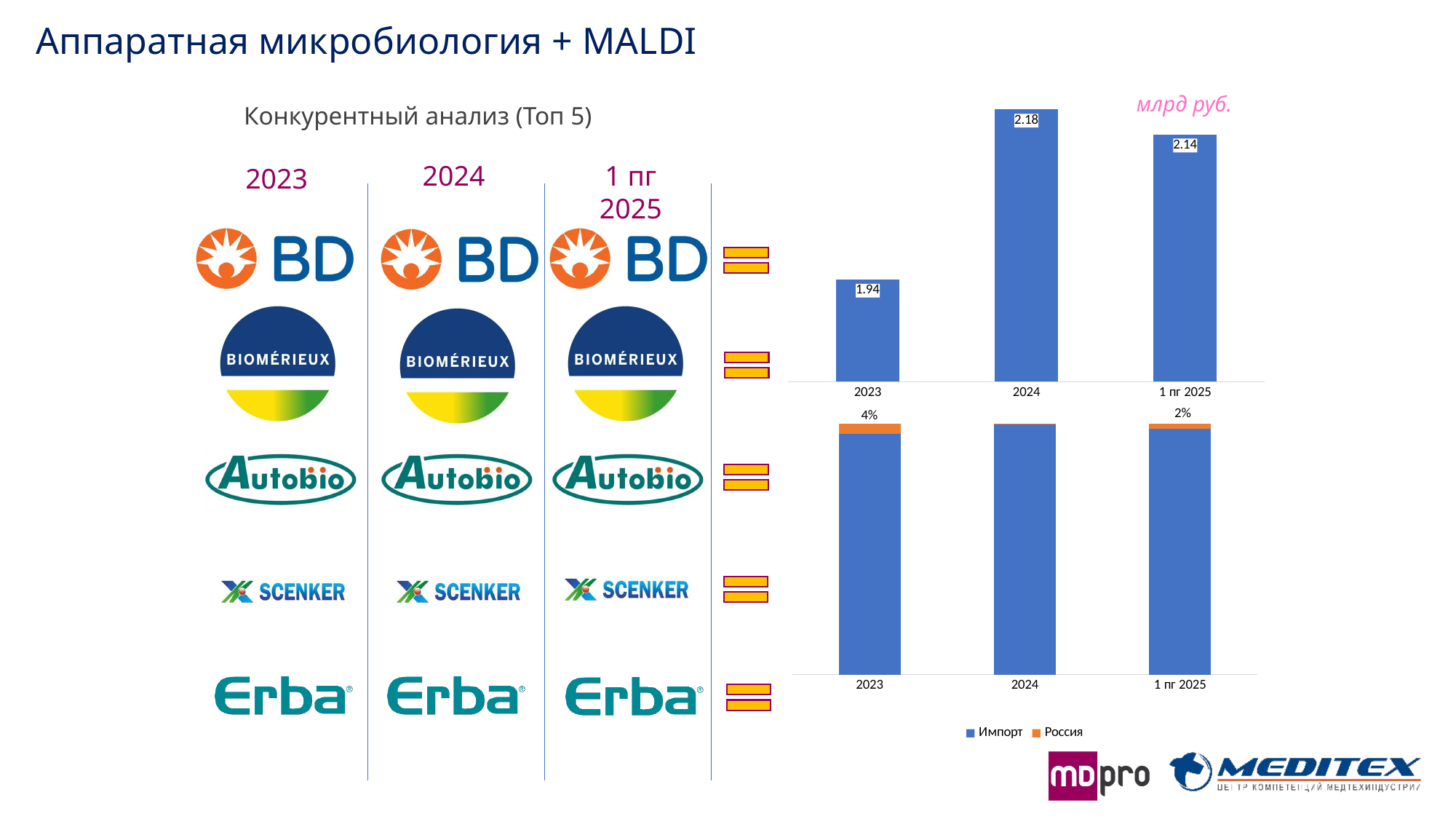
In the top bar chart, which period has the highest value? 2024 In the bottom stacked bar chart, how many series does the legend list? 2 In the top bar chart, how many periods are shown on the x axis? 3 In the bottom stacked bar chart, what is the share labelled for Россия in 1 пг 2025? 2% In the top bar chart, which period has the lowest value? 2023 In the top bar chart, what is the value for 2023? 1.94 In the bottom stacked bar chart, what is the share labelled for Россия in 2023? 4% In the top bar chart, what is the difference between the values for 2024 and 2023? 0.24 In the top bar chart, which is larger, the value for 2024 or the value for 1 пг 2025? 2024 In the top bar chart, what is the value for 2024? 2.18 In the top bar chart, what unit is indicated for the values? млрд руб. In the top bar chart, what is the value for 1 пг 2025? 2.14